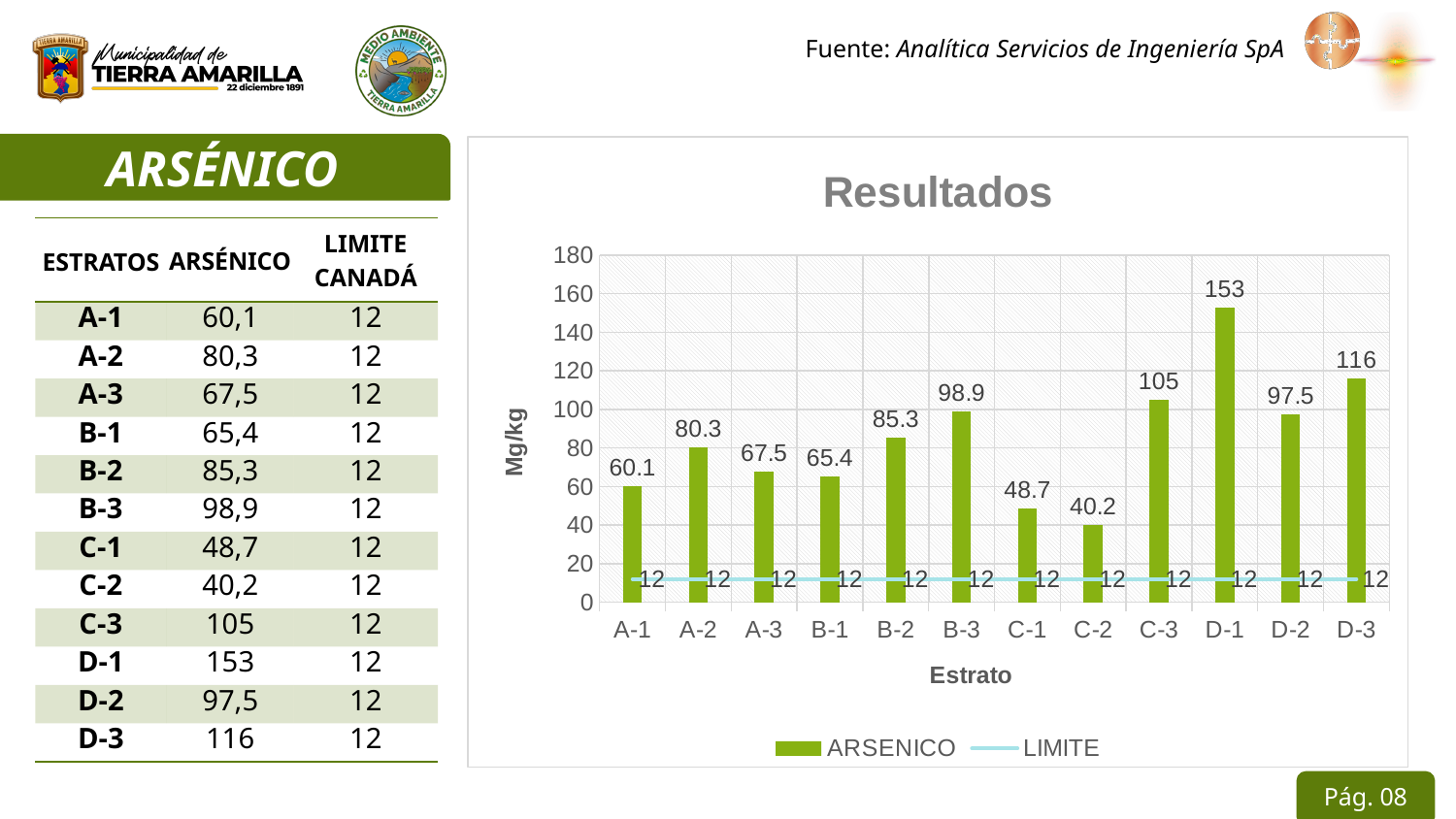
Which estrato has the highest ARSENICO value in the Resultados chart? D-1 Which estrato has the lowest ARSENICO value in the Resultados chart? C-2 How many estratos are plotted on the x axis of the Resultados chart? 12 What is the difference between the ARSENICO values for D-1 and D-3 in the Resultados chart? 37 What kind of chart is used for the ARSENICO series in the Resultados chart? Bar chart What is the ARSENICO value for estrato D-1 in the Resultados chart? 153 What is the LIMITE value shown for estrato A-1 in the Resultados chart? 12 How many series does the legend of the Resultados chart list? 2 What is the ARSENICO value for estrato C-2 in the Resultados chart? 40.2 In the Resultados chart, which has a larger ARSENICO value, B-2 or D-2? D-2 What is the difference between the ARSENICO value for B-3 and the LIMITE value in the Resultados chart? 86.9 What is the y-axis label of the Resultados chart? Mg/kg